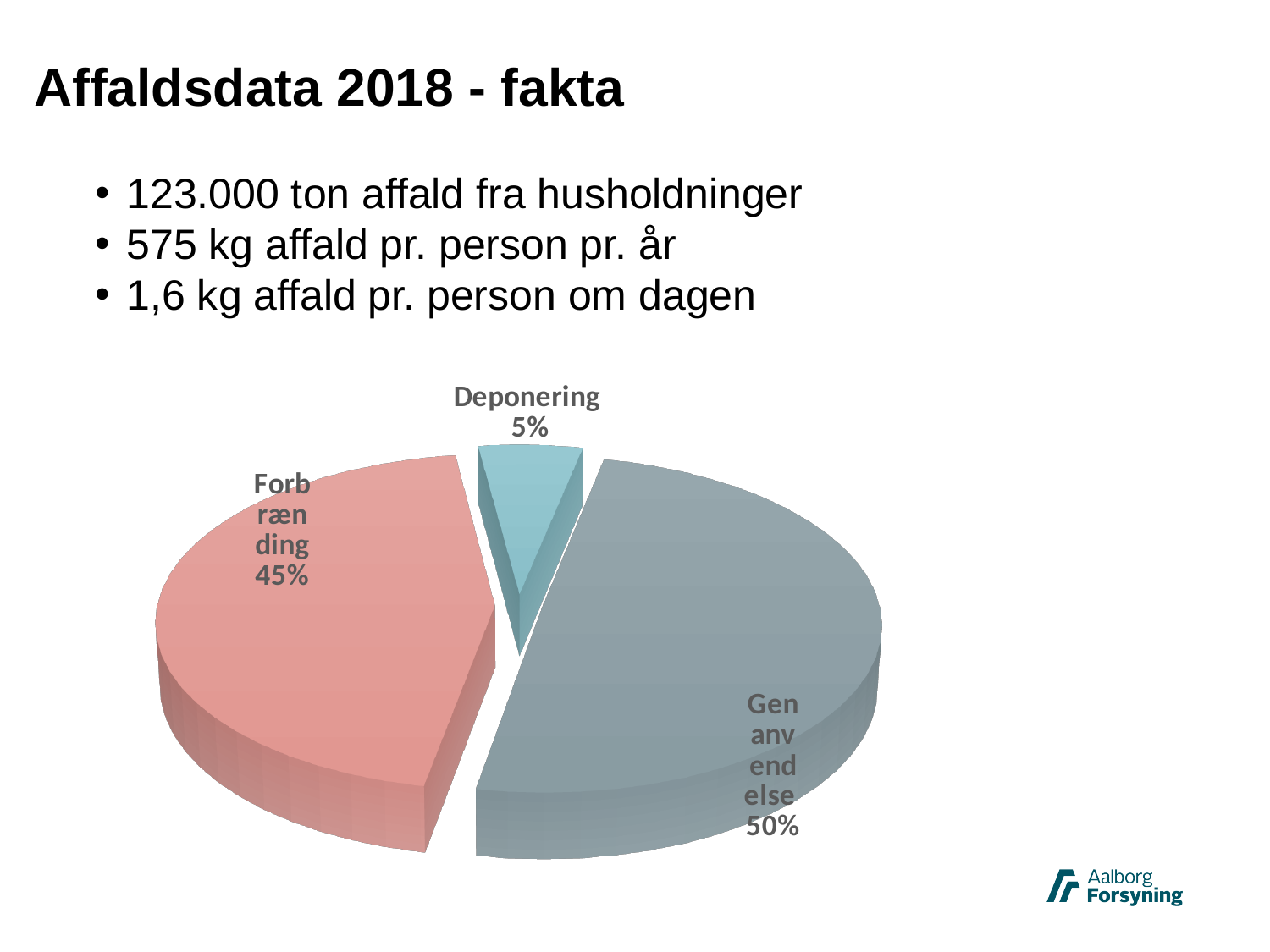
What is the difference in percentage points between Forbrænding and Deponering? 40 percentage points What colour is the Deponering slice? light blue What share of the pie does Deponering have? 5% How many slices does the pie chart have? 3 Which category has the largest slice of the pie? Genanvendelse Which is larger, the share for Forbrænding or the share for Deponering? Forbrænding What is the difference in percentage points between Genanvendelse and Forbrænding? 5 percentage points What colour is the Forbrænding slice? pink/salmon Which category has the smallest slice of the pie? Deponering What share of the pie does Forbrænding have? 45% What kind of chart is shown on the slide? pie chart What share of the pie does Genanvendelse have? 50%